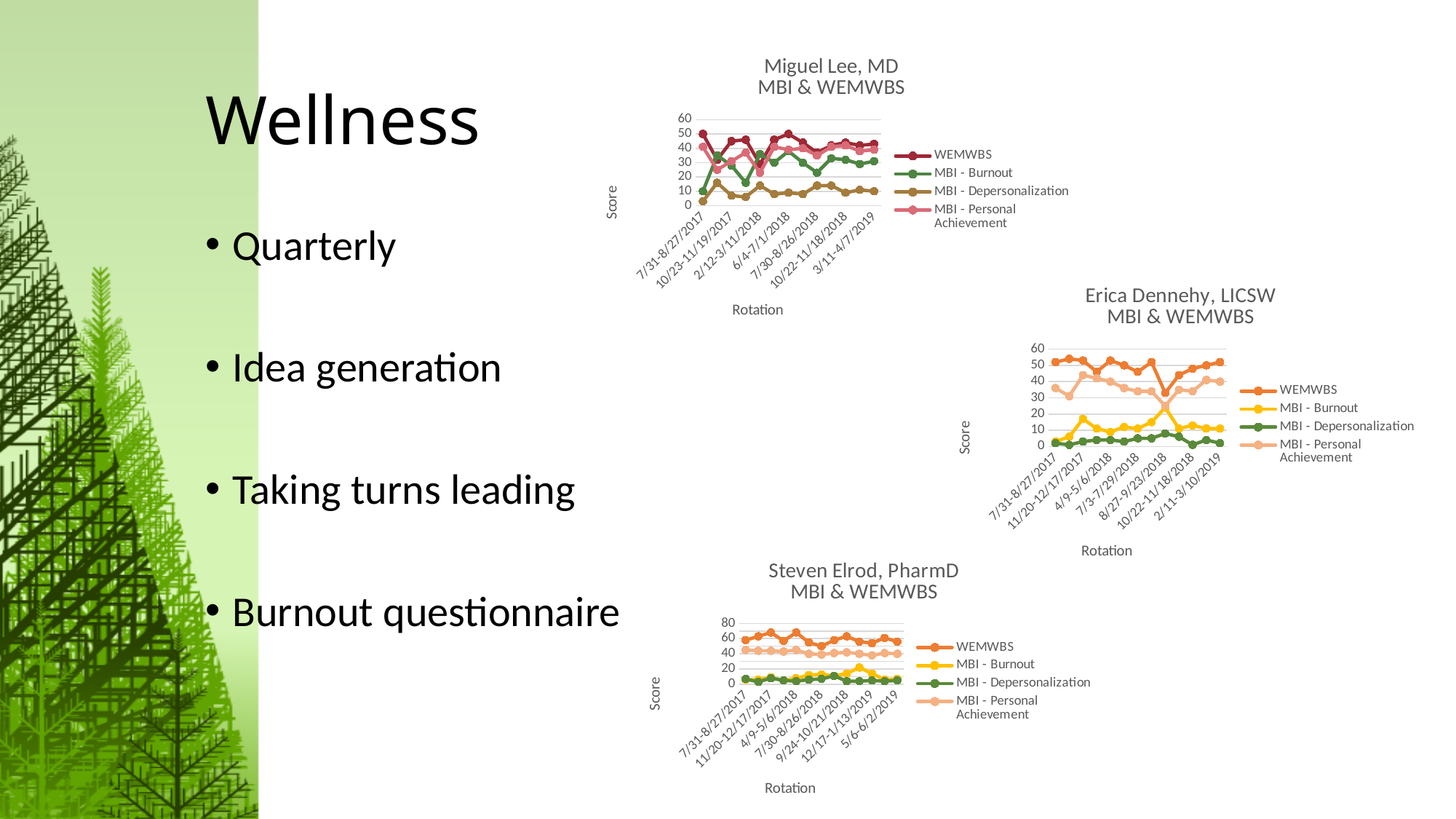
What kind of chart is the 'Miguel Lee, MD MBI & WEMWBS' chart? line chart In the 'Steven Elrod, PharmD MBI & WEMWBS' chart, is the WEMWBS value for the first rotation (7/31-8/27/2017) greater or less than 40? greater In the 'Steven Elrod, PharmD MBI & WEMWBS' chart, is the MBI - Depersonalization value for the first rotation (7/31-8/27/2017) greater or less than 20? less How many series does the legend of the 'Erica Dennehy, LICSW MBI & WEMWBS' chart list? 4 How many series does the legend of the 'Steven Elrod, PharmD MBI & WEMWBS' chart list? 4 In the 'Miguel Lee, MD MBI & WEMWBS' chart, is the WEMWBS value for the first rotation (7/31-8/27/2017) greater or less than 40? greater What is the x-axis label on the 'Miguel Lee, MD MBI & WEMWBS' chart? Rotation What is the y-axis label on the 'Erica Dennehy, LICSW MBI & WEMWBS' chart? Score In the 'Steven Elrod, PharmD MBI & WEMWBS' chart, which is larger for the first rotation (7/31-8/27/2017): WEMWBS or MBI - Burnout? WEMWBS